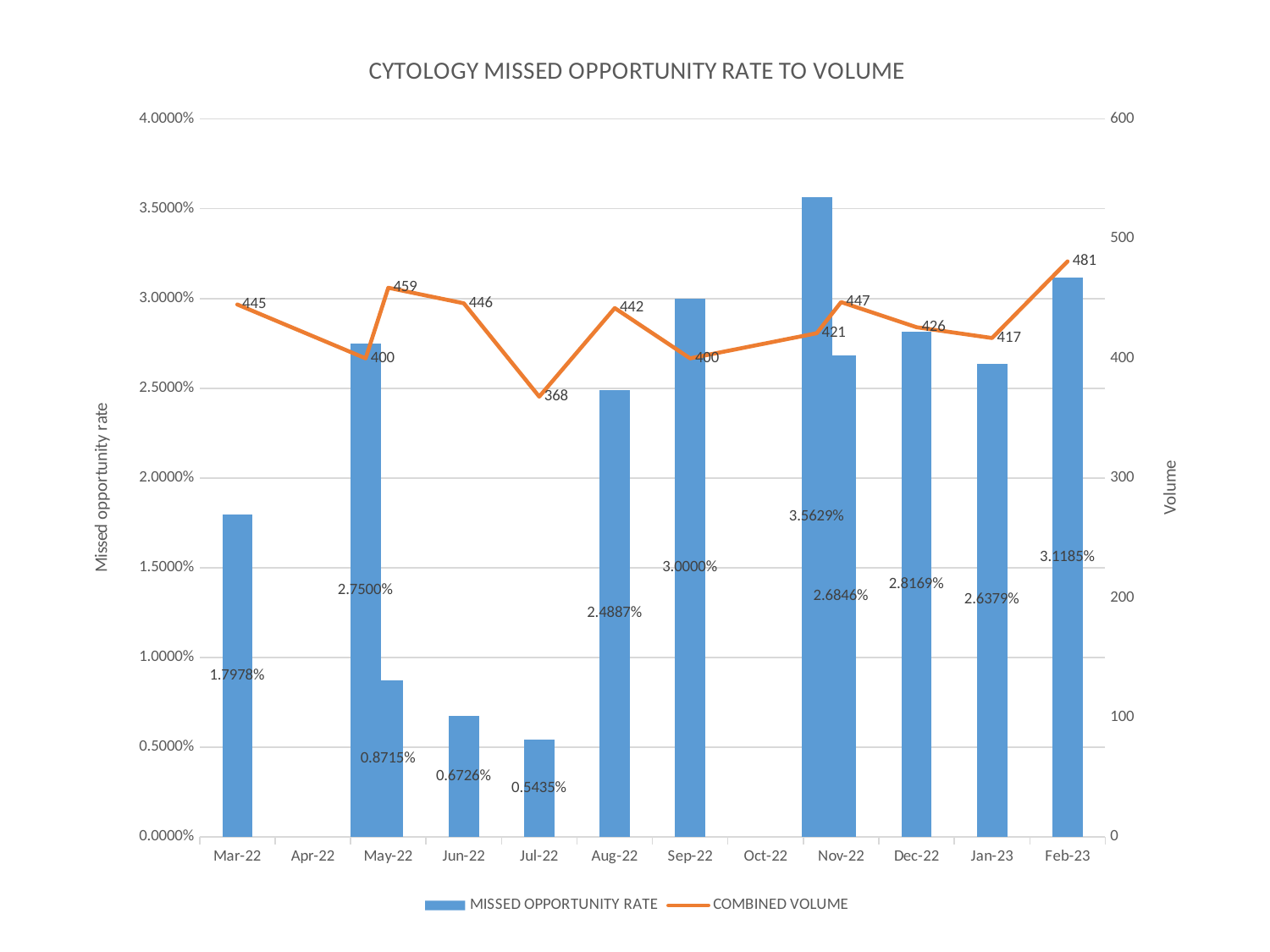
Which month has the highest combined volume? Feb-23 What is the missed opportunity rate for Dec-22? 2.8169% What is the highest missed opportunity rate labelled on the chart? 3.5629% Which month has the lowest combined volume? Jul-22 What is the missed opportunity rate for Jul-22? 0.5435% What is the difference between the combined volume for Feb-23 and for Jul-22? 113 How many series does the legend list? 2 What kind of chart is shown on the slide? A combination bar and line chart Which has the higher missed opportunity rate, Aug-22 or Sep-22? Sep-22 What is the title of the chart? CYTOLOGY MISSED OPPORTUNITY RATE TO VOLUME What is the combined volume for Feb-23? 481 What is the combined volume for Jan-23? 417